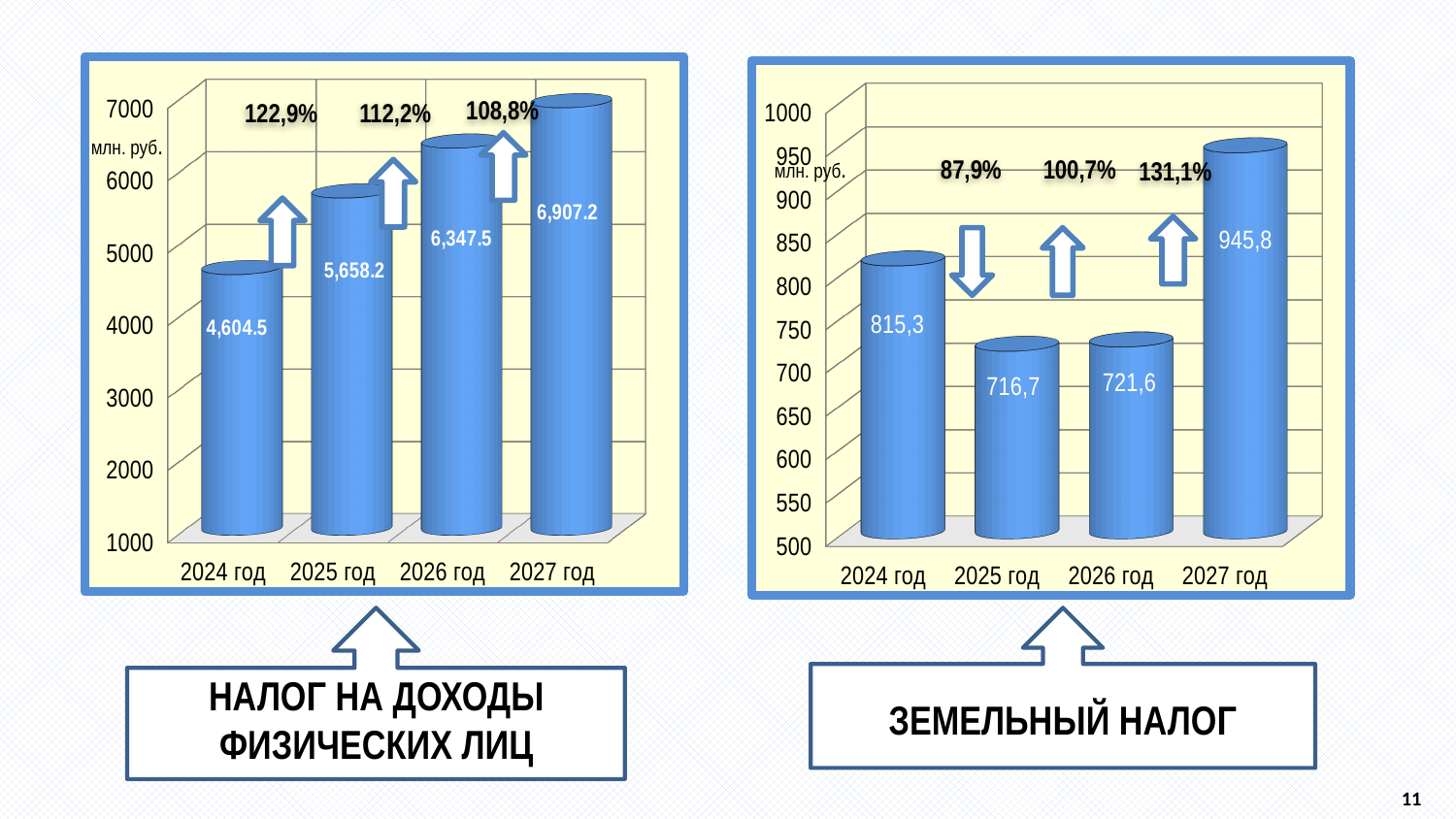
In the chart titled НАЛОГ НА ДОХОДЫ ФИЗИЧЕСКИХ ЛИЦ, what is the value for 2027 год? 6,907.2 In the chart titled ЗЕМЕЛЬНЫЙ НАЛОГ, which year has the highest value? 2027 год In the chart titled ЗЕМЕЛЬНЫЙ НАЛОГ, what is the difference between the values for 2027 год and 2025 год? 229,1 In the chart titled НАЛОГ НА ДОХОДЫ ФИЗИЧЕСКИХ ЛИЦ, do the values rise or fall from 2024 год to 2027 год? rise In the chart titled НАЛОГ НА ДОХОДЫ ФИЗИЧЕСКИХ ЛИЦ, what is the difference between the values for 2027 год and 2024 год? 2,302.7 In the chart titled ЗЕМЕЛЬНЫЙ НАЛОГ, which is larger, the value for 2024 год or 2025 год? 2024 год In the chart titled НАЛОГ НА ДОХОДЫ ФИЗИЧЕСКИХ ЛИЦ, which year has the lowest value? 2024 год In the chart titled НАЛОГ НА ДОХОДЫ ФИЗИЧЕСКИХ ЛИЦ, what percentage is shown above the arrow between 2024 год and 2025 год? 122,9% In the chart titled ЗЕМЕЛЬНЫЙ НАЛОГ, how many years are shown on the x axis? 4 What kind of chart is the chart titled ЗЕМЕЛЬНЫЙ НАЛОГ? bar chart In the chart titled НАЛОГ НА ДОХОДЫ ФИЗИЧЕСКИХ ЛИЦ, what is the value for 2024 год? 4,604.5 In the chart titled ЗЕМЕЛЬНЫЙ НАЛОГ, what is the value for 2025 год? 716,7